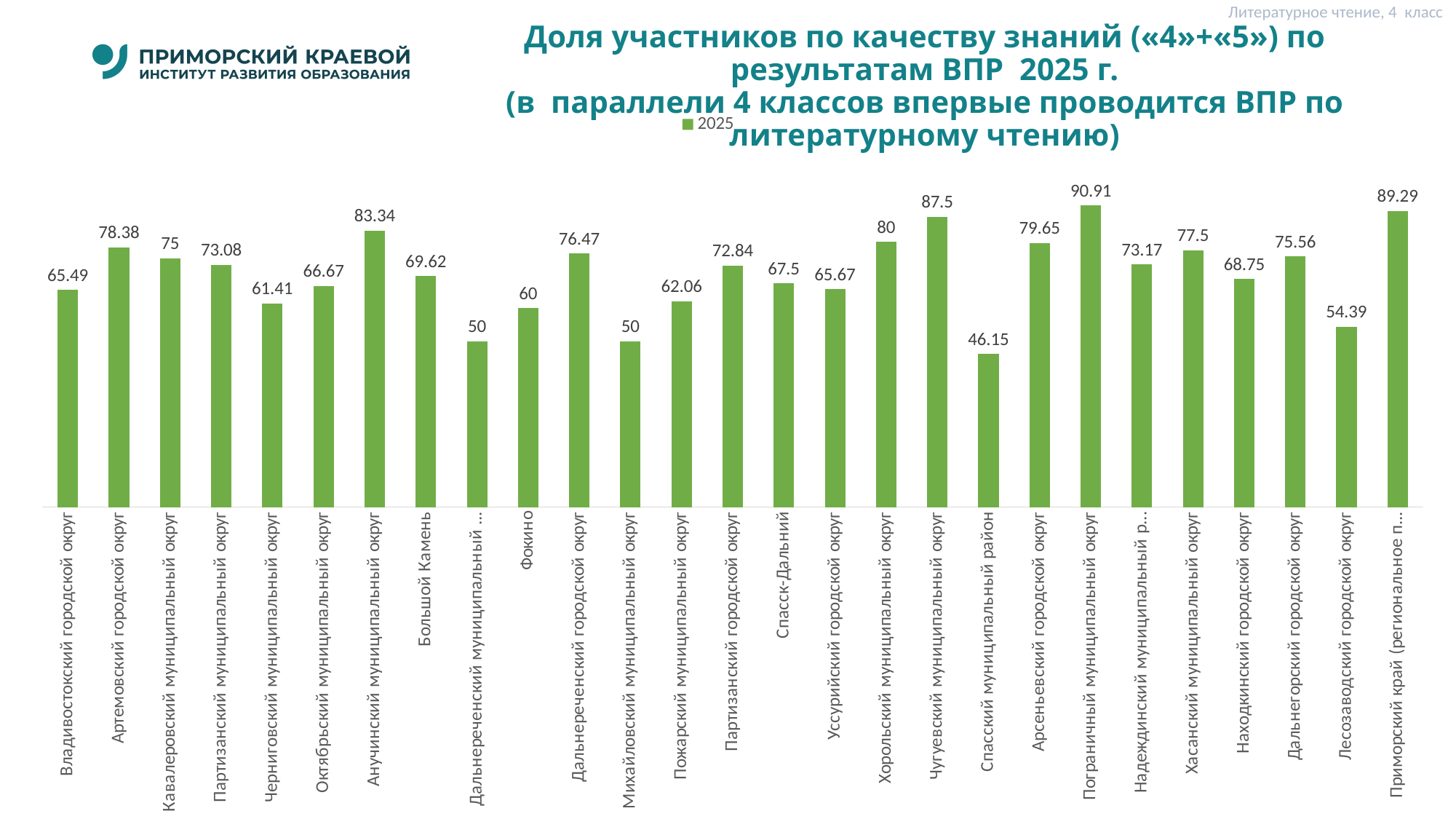
What is the value for Лесозаводский городской округ? 54.39 What is the value for Чугуевский муниципальный округ? 87.5 How many categories are shown on the x axis? 27 What is the difference between the values for Пограничный муниципальный округ and Спасский муниципальный район? 44.76 Which is larger, the value for Хорольский муниципальный округ or the value for Арсеньевский городской округ? Хорольский муниципальный округ What type of chart is shown on the slide? bar chart Which category has the lowest value? Спасский муниципальный район How many series does the legend list? 1 What is the value for Фокино? 60 What is the difference between the values for Анучинский муниципальный округ and Большой Камень? 13.72 What is the value for Артемовский городской округ? 78.38 Which category has the highest value? Пограничный муниципальный округ